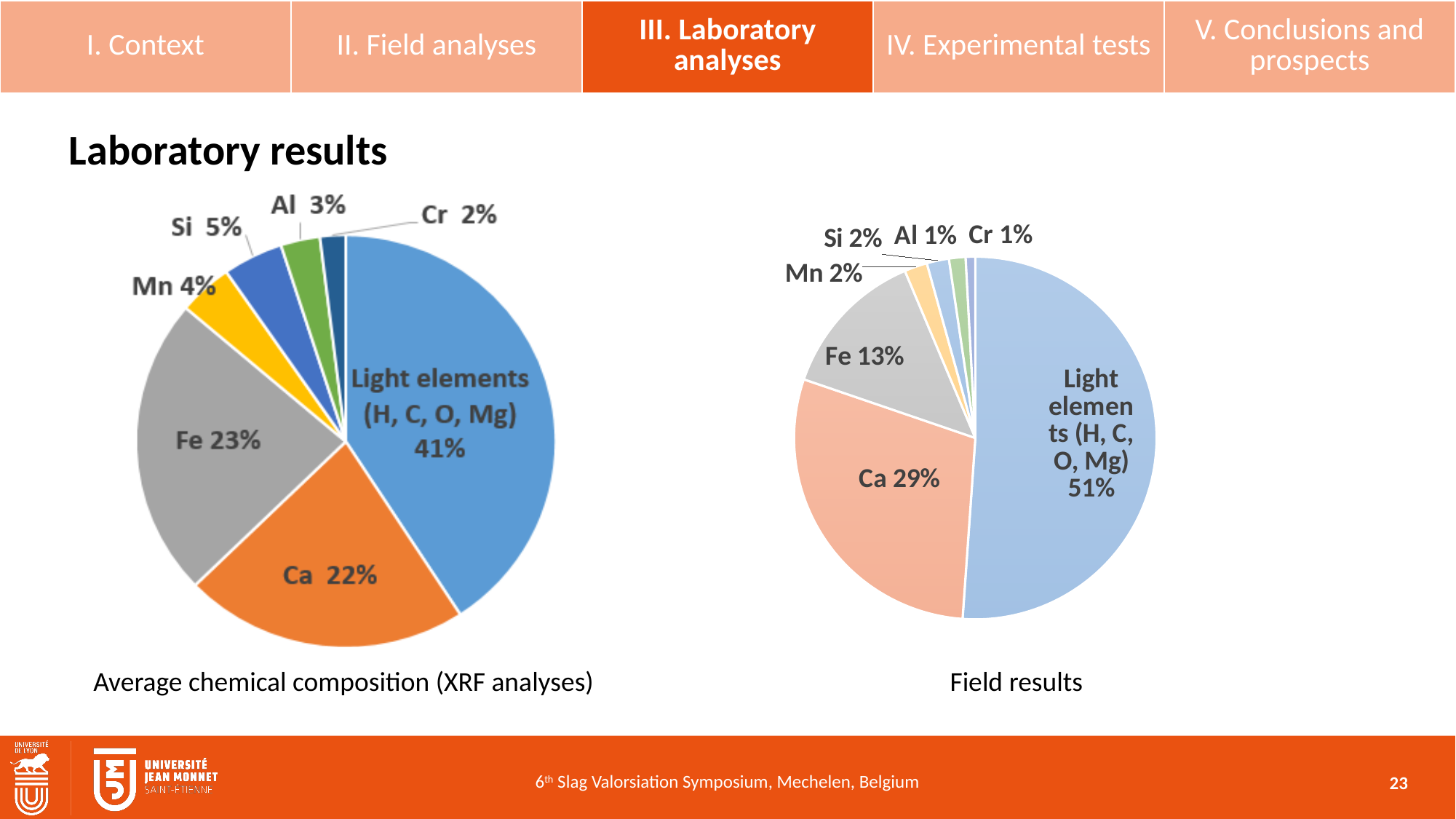
In the 'Field results' pie chart on the right, what share do Light elements (H, C, O, Mg) have? 51% In the 'Average chemical composition (XRF analyses)' pie chart on the left, what share does Fe have? 23% In the 'Field results' pie chart on the right, what share does Ca have? 29% In the 'Average chemical composition (XRF analyses)' pie chart on the left, what is the difference between the Fe share and the Ca share? 1% In the 'Field results' pie chart on the right, what is the difference between the Light elements share and the Ca share? 22% In the 'Field results' pie chart on the right, which categories have the smallest share? Al and Cr In the 'Average chemical composition (XRF analyses)' pie chart on the left, which is larger, the Si share or the Mn share? Si In the 'Average chemical composition (XRF analyses)' pie chart on the left, which category has the largest share? Light elements (H, C, O, Mg) What kind of chart is used for the 'Average chemical composition (XRF analyses)' on the left? Pie chart What is the caption under the pie chart on the right? Field results How many categories are shown in the 'Field results' pie chart on the right? 7 Which chart shows a larger share for Fe, the left 'Average chemical composition (XRF analyses)' chart or the right 'Field results' chart? Average chemical composition (XRF analyses)